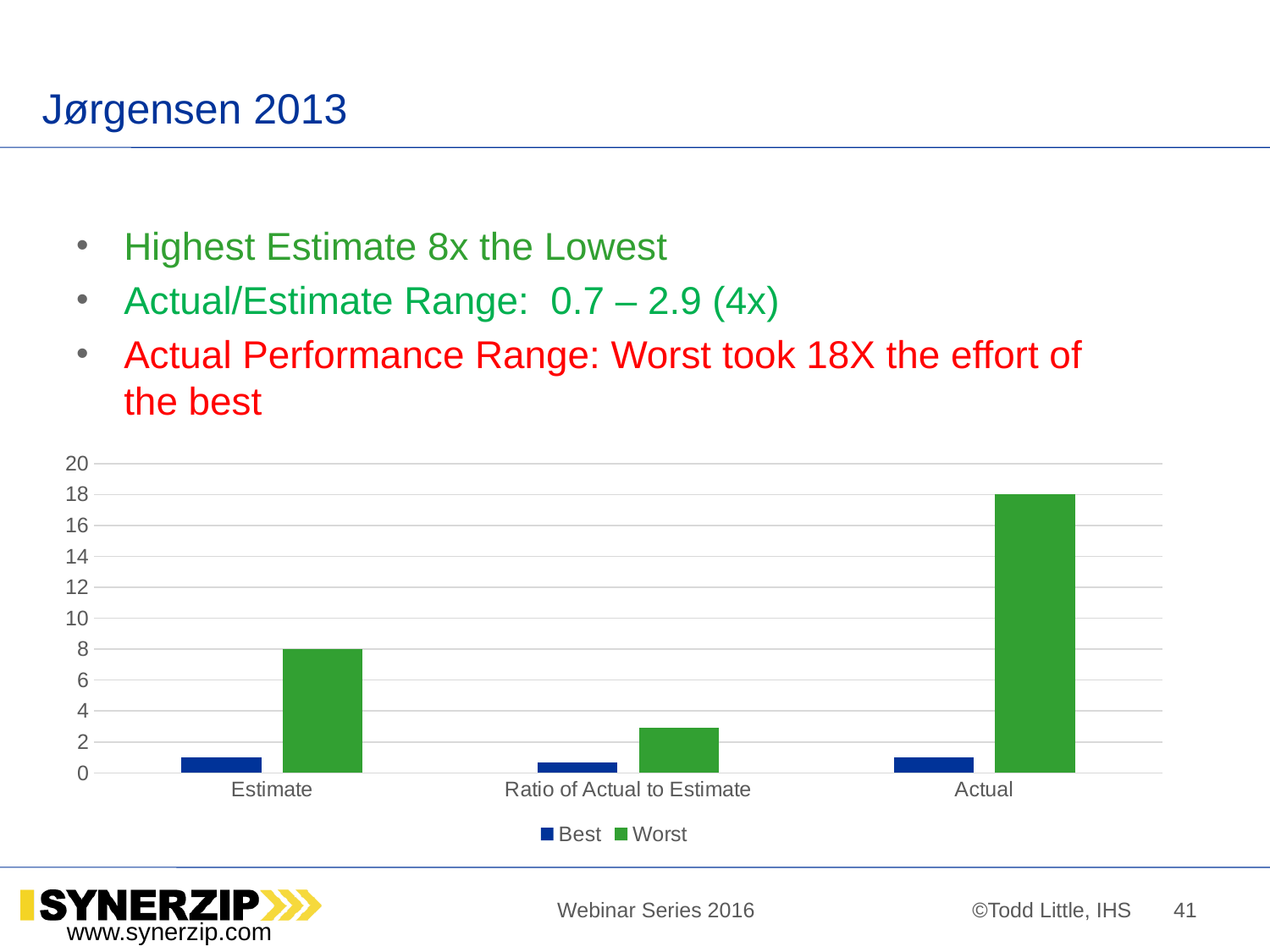
Which category has the lowest Worst value? Ratio of Actual to Estimate How many series does the chart legend list? 2 What is the difference between the Worst value for Actual and the Worst value for Estimate? 10 Is the Best value for Actual greater or less than 2? less Which category has the highest Worst value? Actual Which is larger for the Actual category, the Best value or the Worst value? Worst What is the Worst value for the Estimate category? 8 What type of chart is shown on the slide? bar chart How many categories are shown on the x axis of the chart? 3 What are the two series named in the chart legend? Best and Worst Is the Worst value for Ratio of Actual to Estimate greater or less than 4? less What is the Worst value for the Actual category? 18